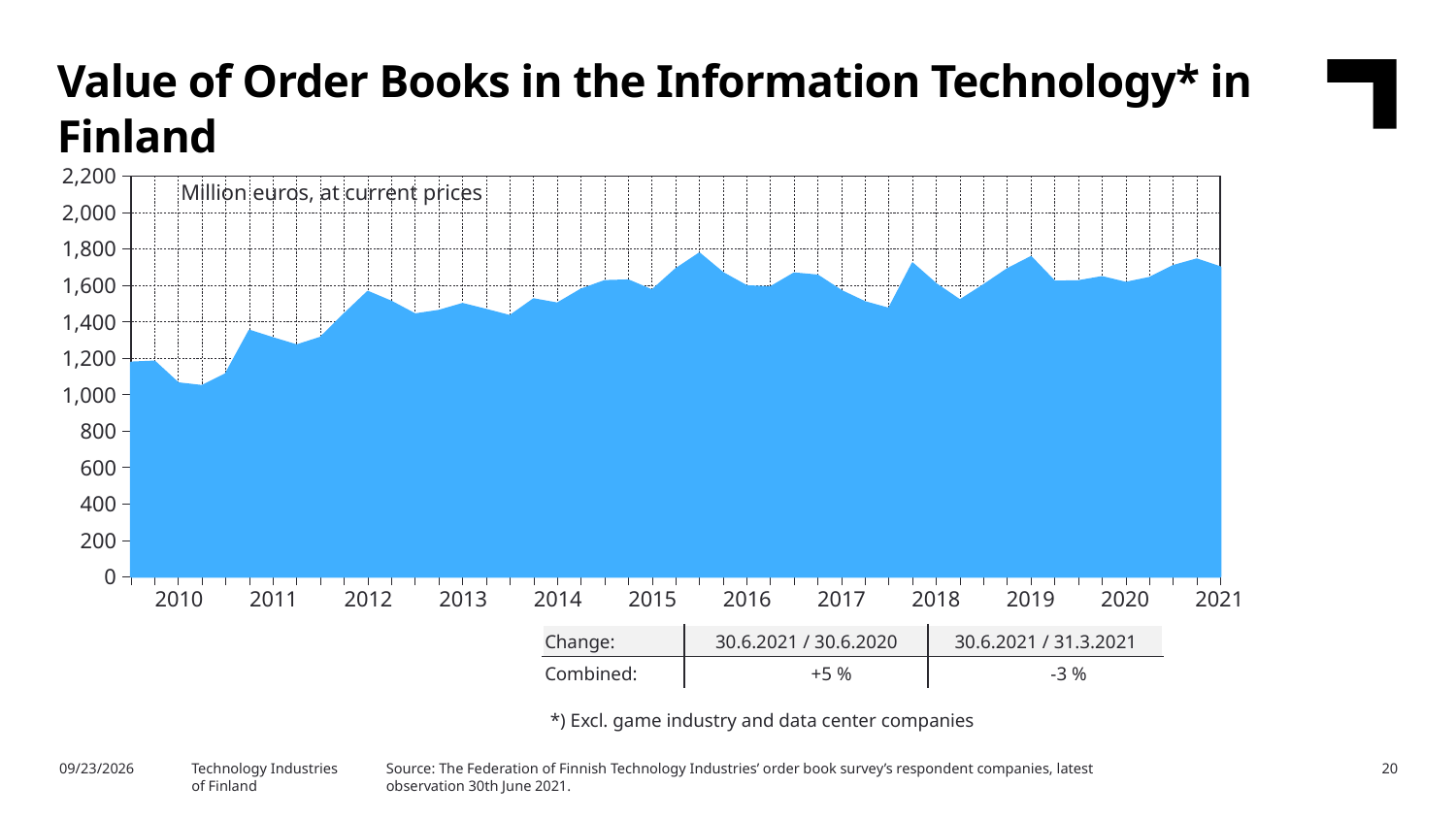
Overall, do the values rise or fall from 2010 to 2021? rise In which year does the chart reach its lowest value? 2010 Which is larger: the value at the start of 2010 or the value at the end of 2021? 2021 What type of chart is shown on the slide? Area chart Is the value at the start of 2010 greater or less than 1,000? greater Is the lowest value in 2010 greater or less than 1,200? less According to the table below the chart, what is the combined change for 30.6.2021 / 30.6.2020? +5 % Is the value at the end of the series in 2021 greater or less than 1,600? greater What is the title of the chart? Value of Order Books in the Information Technology* in Finland In what unit are the values on the chart expressed, according to the label inside the plot area? Million euros, at current prices How many years are labelled on the x axis of the chart? 12